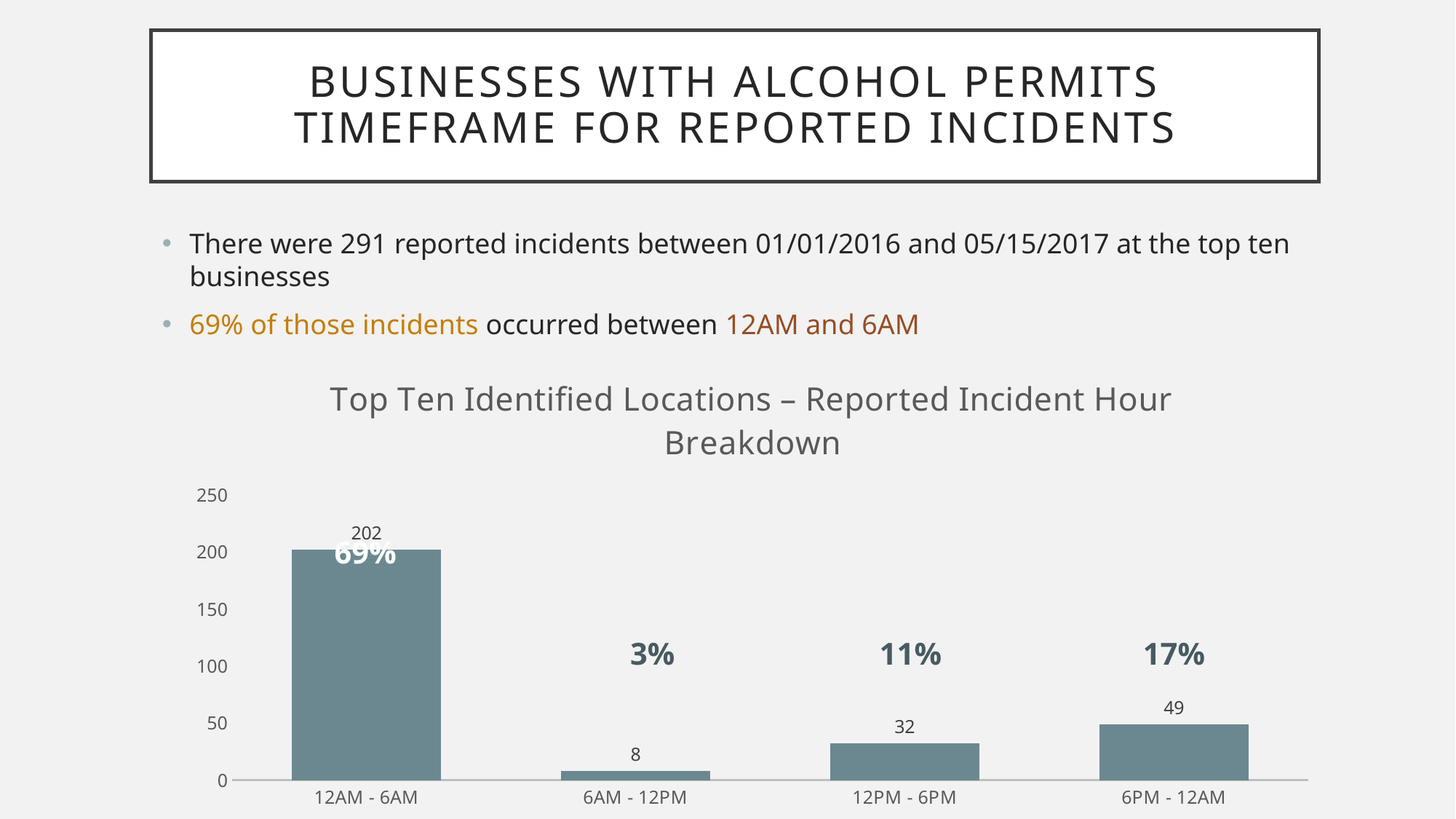
What is the value for 12PM - 6PM? 32 What is the title of the chart? Top Ten Identified Locations – Reported Incident Hour Breakdown How many time periods are shown on the x axis? 4 What is the difference between the values for 12AM - 6AM and 6PM - 12AM? 153 What kind of chart is shown? bar chart What is the value for 6AM - 12PM? 8 What is the value for 12AM - 6AM? 202 Which time period has the lowest number of reported incidents? 6AM - 12PM Which time period has the highest number of reported incidents? 12AM - 6AM What is the value for 6PM - 12AM? 49 Which is larger, the value for 12PM - 6PM or the value for 6PM - 12AM? 6PM - 12AM What percentage label is shown above the 6PM - 12AM bar? 17%